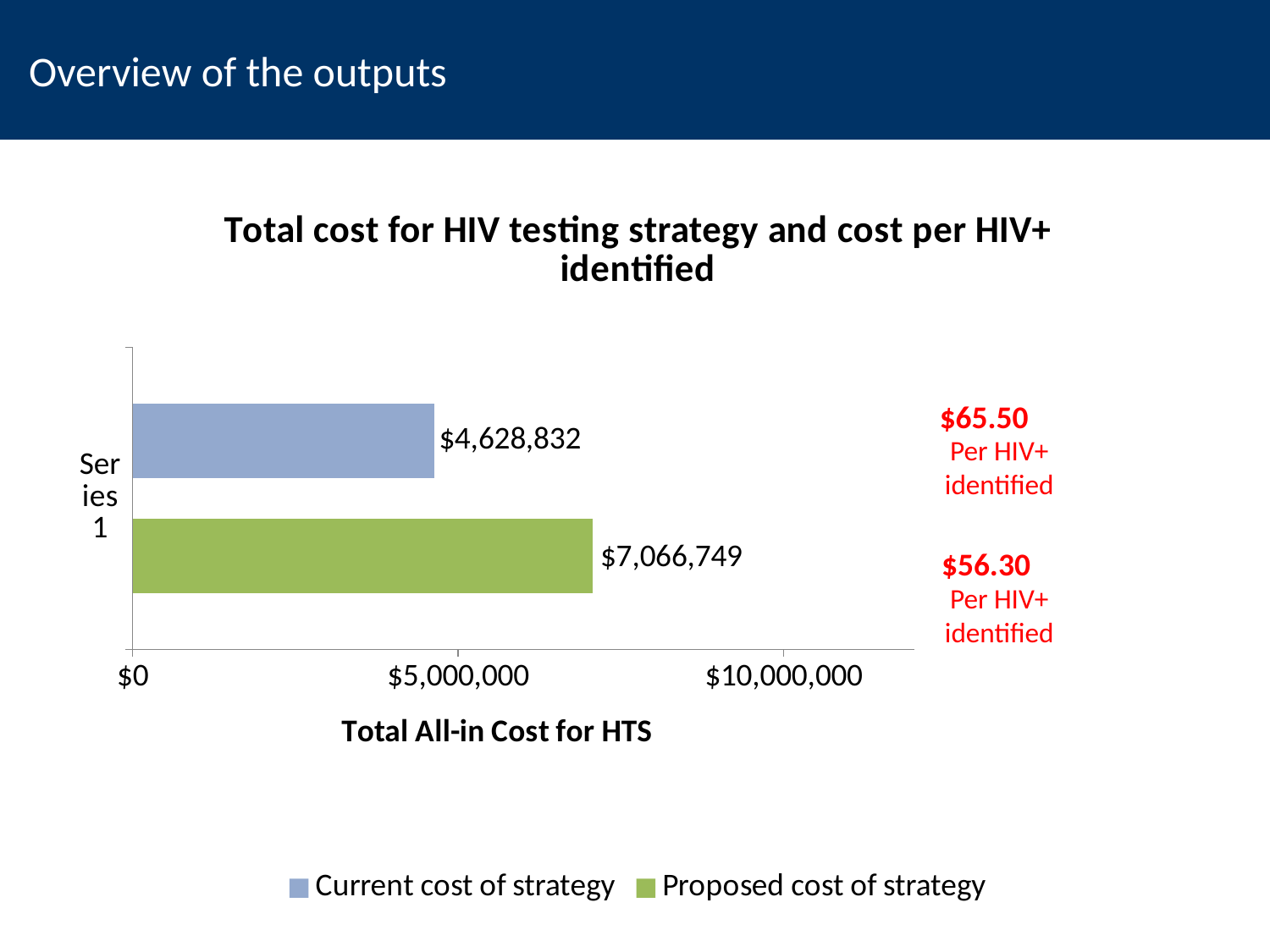
What is the label of the horizontal axis? Total All-in Cost for HTS Is the value for Proposed cost of strategy greater or less than $5,000,000? greater What is the value of the Proposed cost of strategy bar? $7,066,749 How many series does the legend list? 2 Is the Current cost of strategy larger or smaller than the Proposed cost of strategy? smaller What is the value of the Current cost of strategy bar? $4,628,832 Which series has the lower total all-in cost for HTS? Current cost of strategy What is the title of the chart? Total cost for HIV testing strategy and cost per HIV+ identified What is the difference between the Proposed cost of strategy and the Current cost of strategy? $2,437,917 What kind of chart is shown on the slide? Bar chart Which series has the higher total all-in cost for HTS? Proposed cost of strategy Is the value for Current cost of strategy greater or less than $5,000,000? less